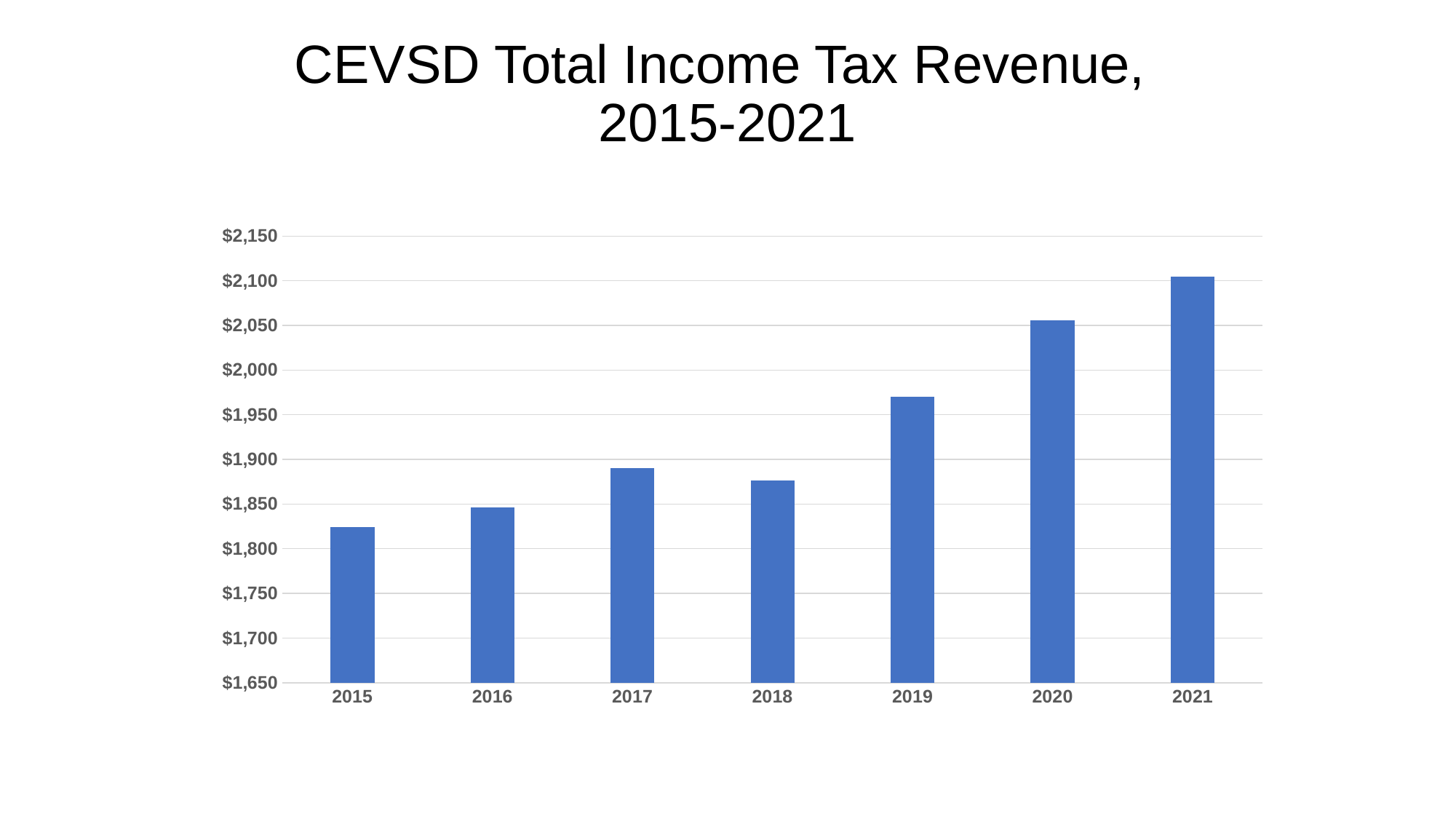
What kind of chart is shown on the slide? bar chart Is the value for 2015 greater or less than $1,850? less What is the title of the chart? CEVSD Total Income Tax Revenue, 2015-2021 Is the value for 2020 greater or less than $2,050? greater Which year has the lowest total income tax revenue? 2015 How many years are plotted on the chart? 7 Is the value for 2021 greater or less than $2,100? greater Which year has the larger value, 2018 or 2019? 2019 Which year has the highest total income tax revenue? 2021 Do the values generally rise or fall from 2015 to 2021? rise